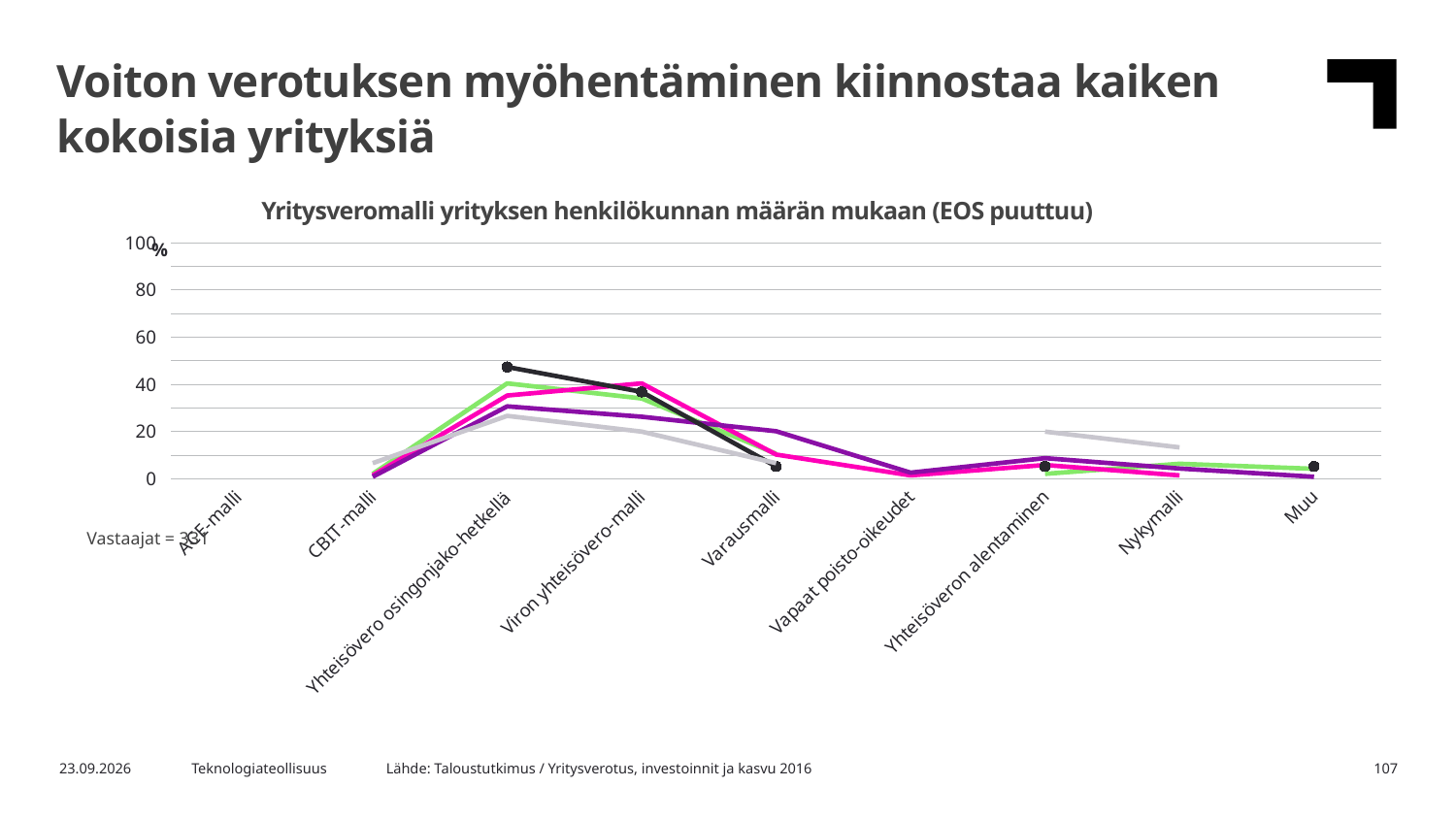
Is the value of the black line for Yhteisövero osingonjako-hetkellä greater or less than 40? greater Is the value of the pink line for Vapaat poisto-oikeudet greater or less than 20? less Do the lines rise or fall between CBIT-malli and Yhteisövero osingonjako-hetkellä? rise Which category has the highest peak across the lines in the chart? Yhteisövero osingonjako-hetkellä Do the lines rise or fall between Varausmalli and Vapaat poisto-oikeudet? fall Is the value of the black line for Varausmalli greater or less than 20? less How many categories are shown on the x axis of the chart? 9 What is the title of the chart? Yritysveromalli yrityksen henkilökunnan määrän mukaan (EOS puuttuu) For the black line, which is larger: the value for Yhteisövero osingonjako-hetkellä or the value for Varausmalli? Yhteisövero osingonjako-hetkellä What is the highest value shown on the y axis of the chart? 100 What kind of chart is shown on the slide? line chart